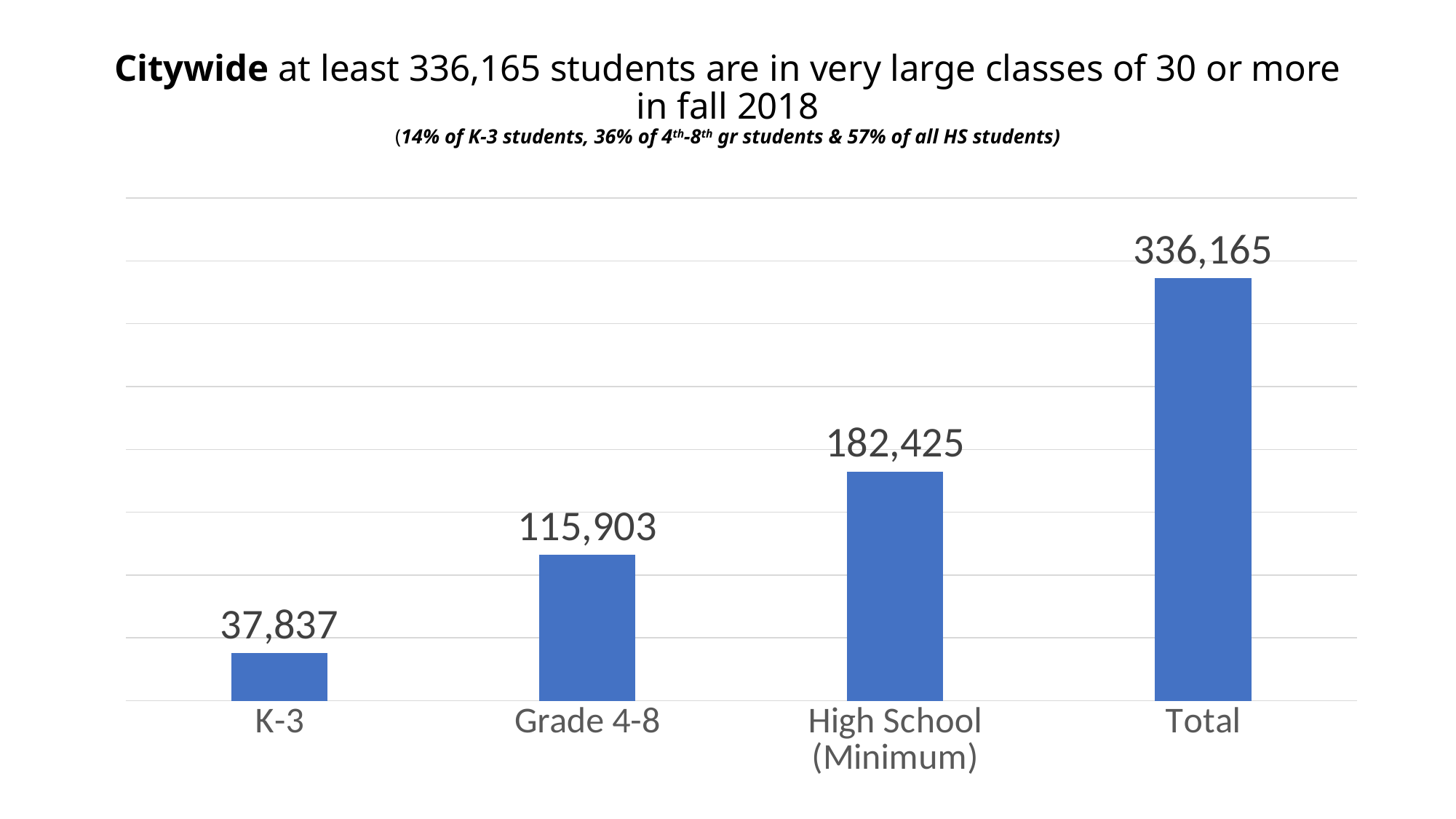
What is the value for High School (Minimum)? 182,425 Which is larger, the value for Grade 4-8 or the value for High School (Minimum)? High School (Minimum) How many categories are shown on the x axis? 4 What kind of chart is shown on the slide? Bar chart What is the value for Total? 336,165 What is the difference between the High School (Minimum) value and the Grade 4-8 value? 66,522 What is the value for K-3? 37,837 What is the difference between the Grade 4-8 value and the K-3 value? 78,066 What is the value for Grade 4-8? 115,903 Do the values rise or fall from left to right along the x axis? Rise Which category has the lowest value? K-3 Which category has the highest value? Total